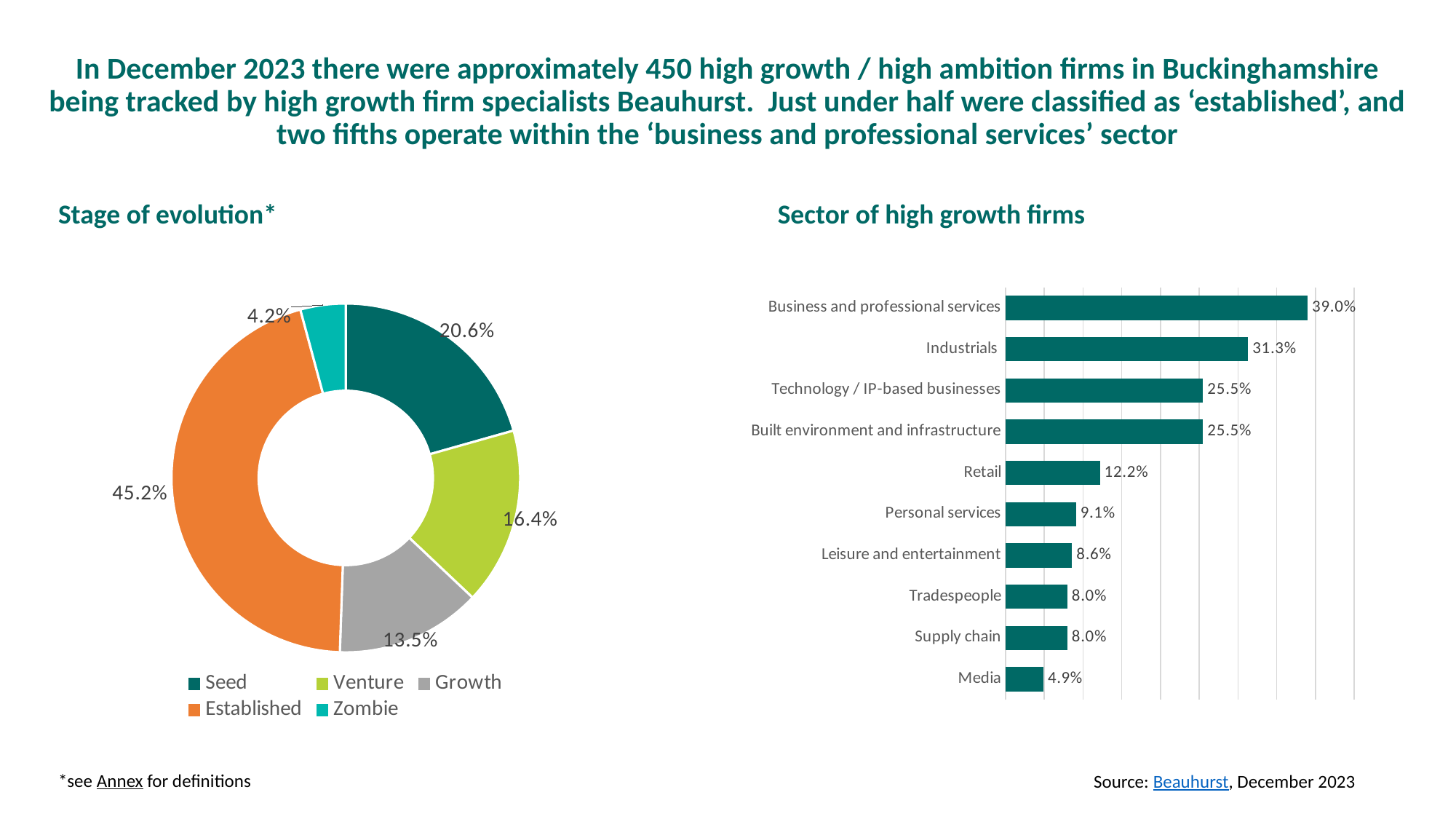
In the 'Stage of evolution*' chart, what share of firms are at the Seed stage? 20.6% In the 'Sector of high growth firms' chart, which sector has the lowest value? Media In the 'Stage of evolution*' chart, which stage has the largest share? Established What kind of chart is the 'Stage of evolution*' chart? Doughnut chart In the 'Sector of high growth firms' chart, what is the value for Industrials? 31.3% In the 'Stage of evolution*' chart, which stage has the smallest share? Zombie In the 'Sector of high growth firms' chart, how many sectors are shown? 10 In the 'Stage of evolution*' chart, what is the difference between the Venture and Growth shares? 2.9% In the 'Stage of evolution*' chart, what share of firms are classified as Established? 45.2% In the 'Sector of high growth firms' chart, what is the difference between Business and professional services and Retail? 26.8% In the 'Sector of high growth firms' chart, which sector has the highest value? Business and professional services In the 'Stage of evolution*' chart, how many stages does the legend list? 5